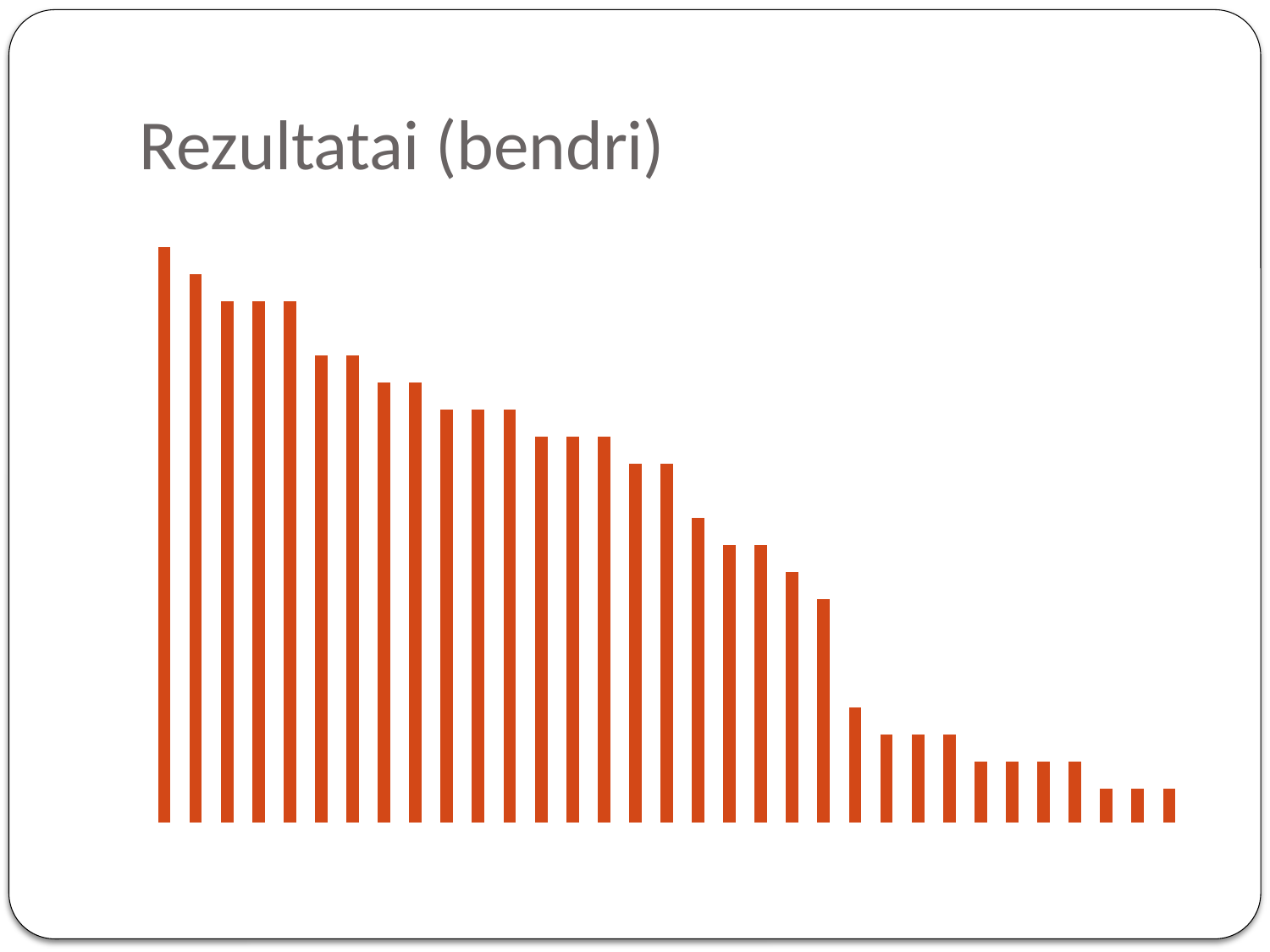
Which is larger, the leftmost bar or the rightmost bar? the leftmost bar Which bar is the tallest in the chart: the leftmost or the rightmost? the leftmost How many bars are plotted in the chart? 33 What is the title of the chart on the slide? Rezultatai (bendri) Do the bar values rise or fall from left to right along the x axis? fall Is the second bar from the left taller or shorter than the first bar? shorter What kind of chart is shown on the slide? bar chart What colour are the bars in the chart? orange